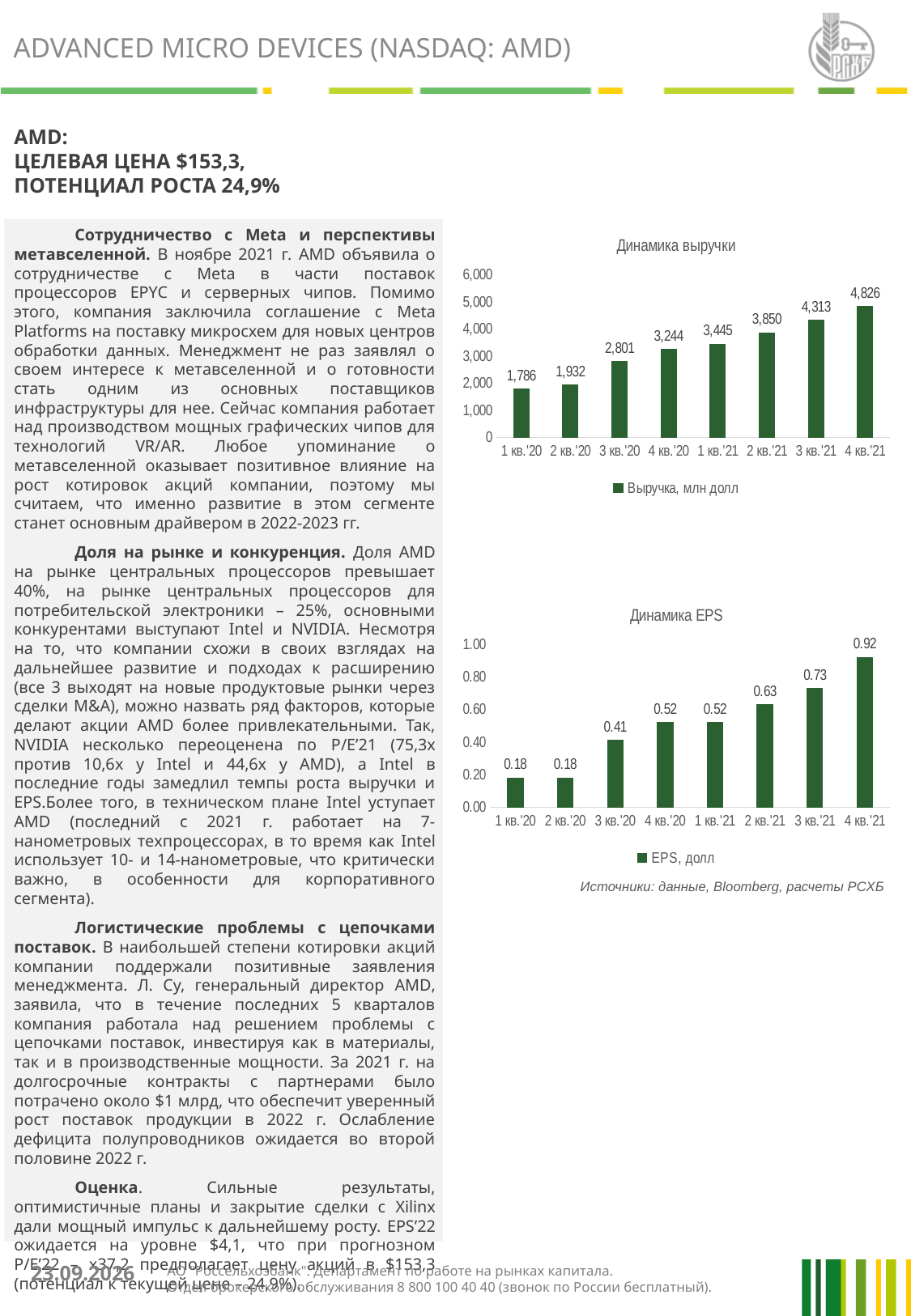
In the 'Динамика EPS' chart, which quarter has the highest EPS? 4 кв.'21 In the 'Динамика выручки' chart, which quarter has the lowest revenue? 1 кв.'20 In the 'Динамика EPS' chart, what is the EPS value for 3 кв.'20? 0.41 In the 'Динамика выручки' chart, do the revenue values rise or fall from 1 кв.'20 to 4 кв.'21? rise In the 'Динамика EPS' chart, what is the EPS value for 4 кв.'21? 0.92 What type of chart is the 'Динамика EPS' chart? bar chart In the 'Динамика EPS' chart, which is larger: the EPS for 2 кв.'21 or 3 кв.'21? 3 кв.'21 In the 'Динамика выручки' chart, what is the revenue value for 4 кв.'21? 4,826 In the 'Динамика выручки' chart, what is the difference between the revenue for 4 кв.'21 and 3 кв.'21? 513 In the 'Динамика выручки' chart, what is the revenue value for 3 кв.'20? 2,801 In the 'Динамика выручки' chart, how many quarters are shown on the x axis? 8 In the 'Динамика EPS' chart, what is the difference between the EPS for 4 кв.'21 and 1 кв.'21? 0.40